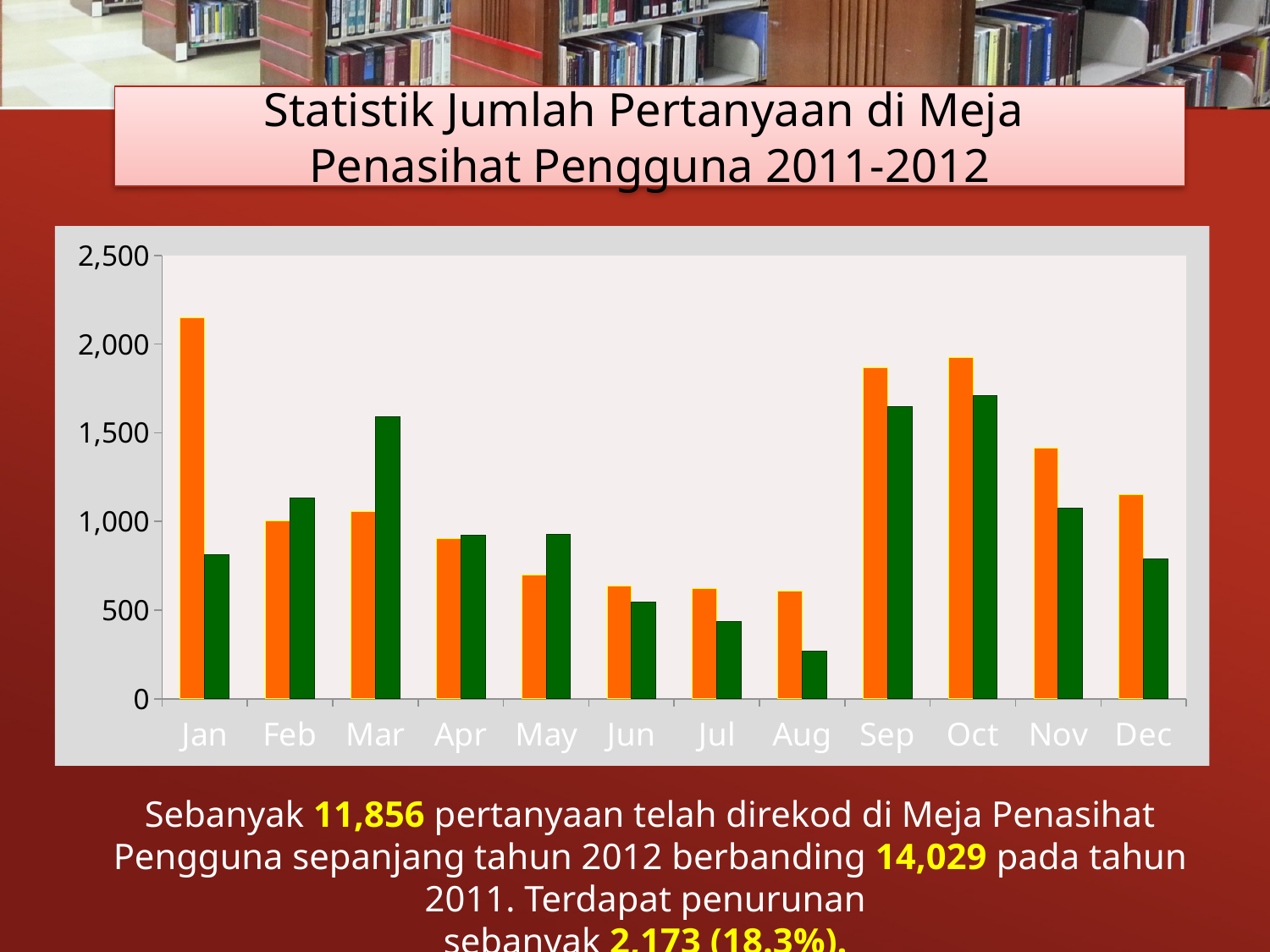
How many months are shown on the x axis of the chart? 12 Is the green bar for Aug greater or less than 500? less Is the orange bar for Nov greater or less than 1,000? greater For Mar, which bar is taller, the orange bar or the green bar? green What is the title of the chart? Statistik Jumlah Pertanyaan di Meja Penasihat Pengguna 2011-2012 How many bars are plotted for each month in the chart? 2 For Jan, which bar is taller, the orange bar or the green bar? orange Is the orange bar for Jan greater or less than 2,000? greater In which month is the orange bar the highest? Jan What kind of chart is shown on the slide? bar chart In which month is the green bar the lowest? Aug